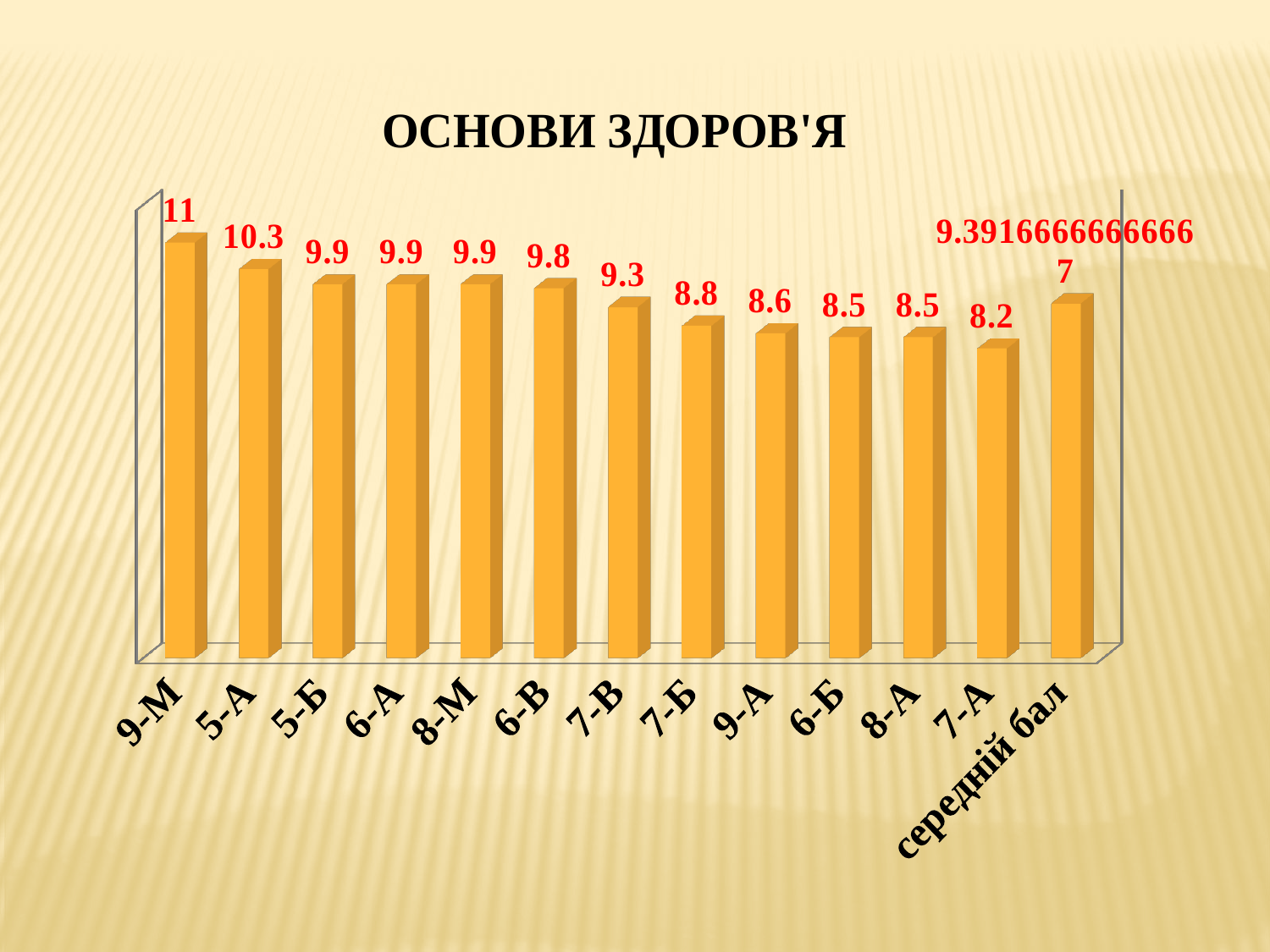
What is the value for 5-А? 10.3 What is the value shown for середній бал? 9.39166666666667 Which class has the lowest value? 7-А What is the value for 7-В? 9.3 Which is larger, the value for 5-А or the value for 7-Б? 5-А Which class has the highest value? 9-М What is the difference between the values for 9-М and 7-А? 2.8 How many bars are shown in the chart? 13 What is the title of the chart? ОСНОВИ ЗДОРОВ'Я What is the value for 9-М? 11 What is the value for 7-А? 8.2 What kind of chart is shown on the slide? bar chart